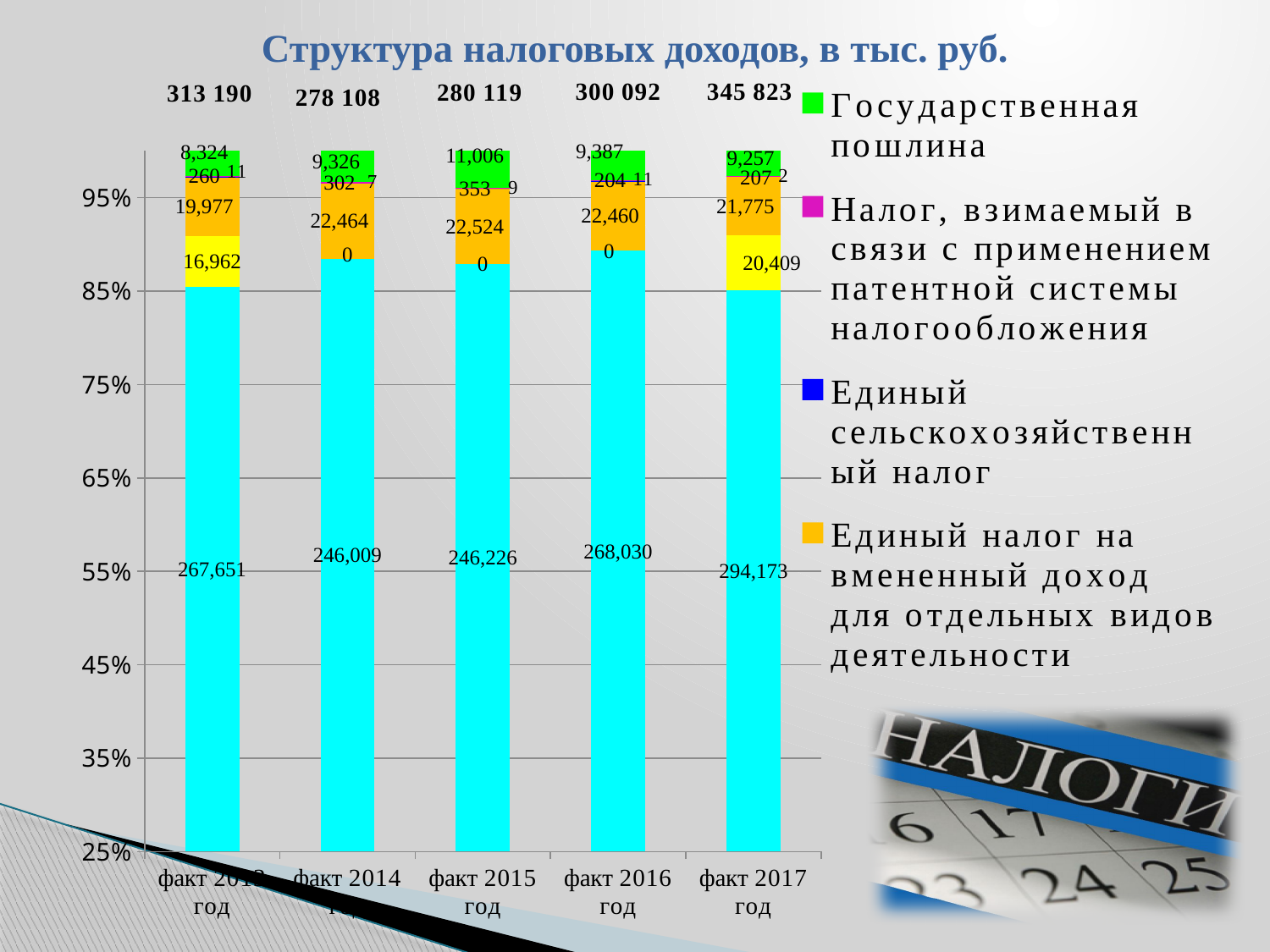
Which year has the lowest total printed above its bar? факт 2014 год Which year has the highest value of Государственная пошлина? факт 2015 год What is the value of Государственная пошлина for факт 2016 год? 9,387 What is the title of the chart? Структура налоговых доходов, в тыс. руб. What is the value of Налог, взимаемый в связи с применением патентной системы налогообложения for факт 2015 год? 353 Which year has the highest total printed above its bar? факт 2017 год What is the value of Единый сельскохозяйственный налог for факт 2017 год? 2 What total is printed above the bar for факт 2017 год? 345 823 Which is larger: Единый налог на вмененный доход для отдельных видов деятельности for факт 2016 год or for факт 2017 год? факт 2016 год What is the value of Единый налог на вмененный доход для отдельных видов деятельности for факт 2015 год? 22,524 What is the difference between Государственная пошлина for факт 2015 год and факт 2014 год? 1,680 How many bars are shown in the chart? 5